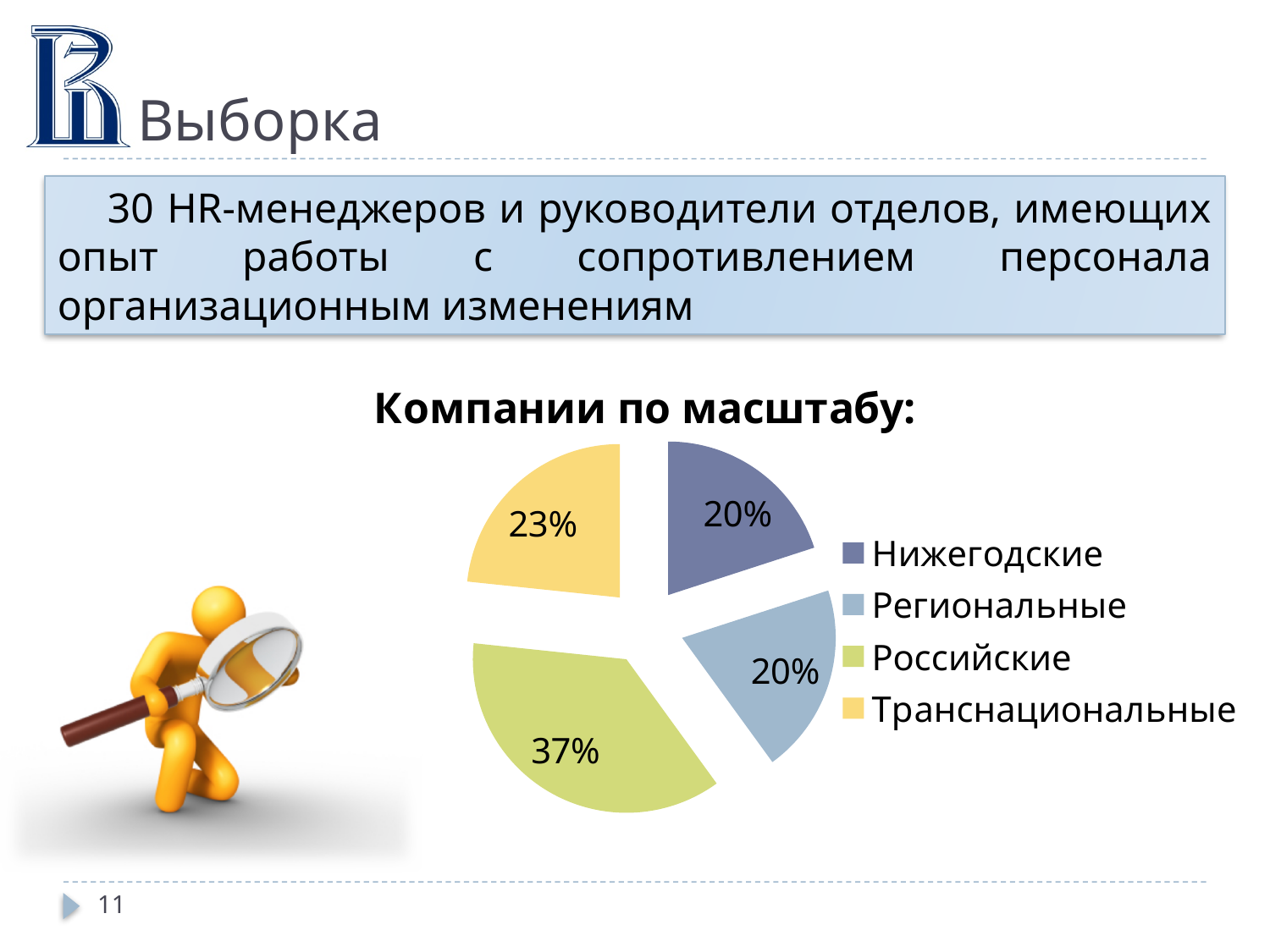
What share of the pie is labelled Транснациональные? 23% What is the difference in percentage points between the Российские and Нижегодские slices? 17 Which slice is larger, Транснациональные or Нижегодские? Транснациональные Which category has the largest slice of the pie? Российские What is the title of the chart? Компании по масштабу: What is the difference in percentage points between the Российские and Транснациональные slices? 14 What share of the pie is labelled Нижегодские? 20% Which colour is used for the Транснациональные slice? yellow How many categories does the legend list? 4 What share of the pie is labelled Региональные? 20% What type of chart is shown on the slide? pie chart What share of the pie is labelled Российские? 37%